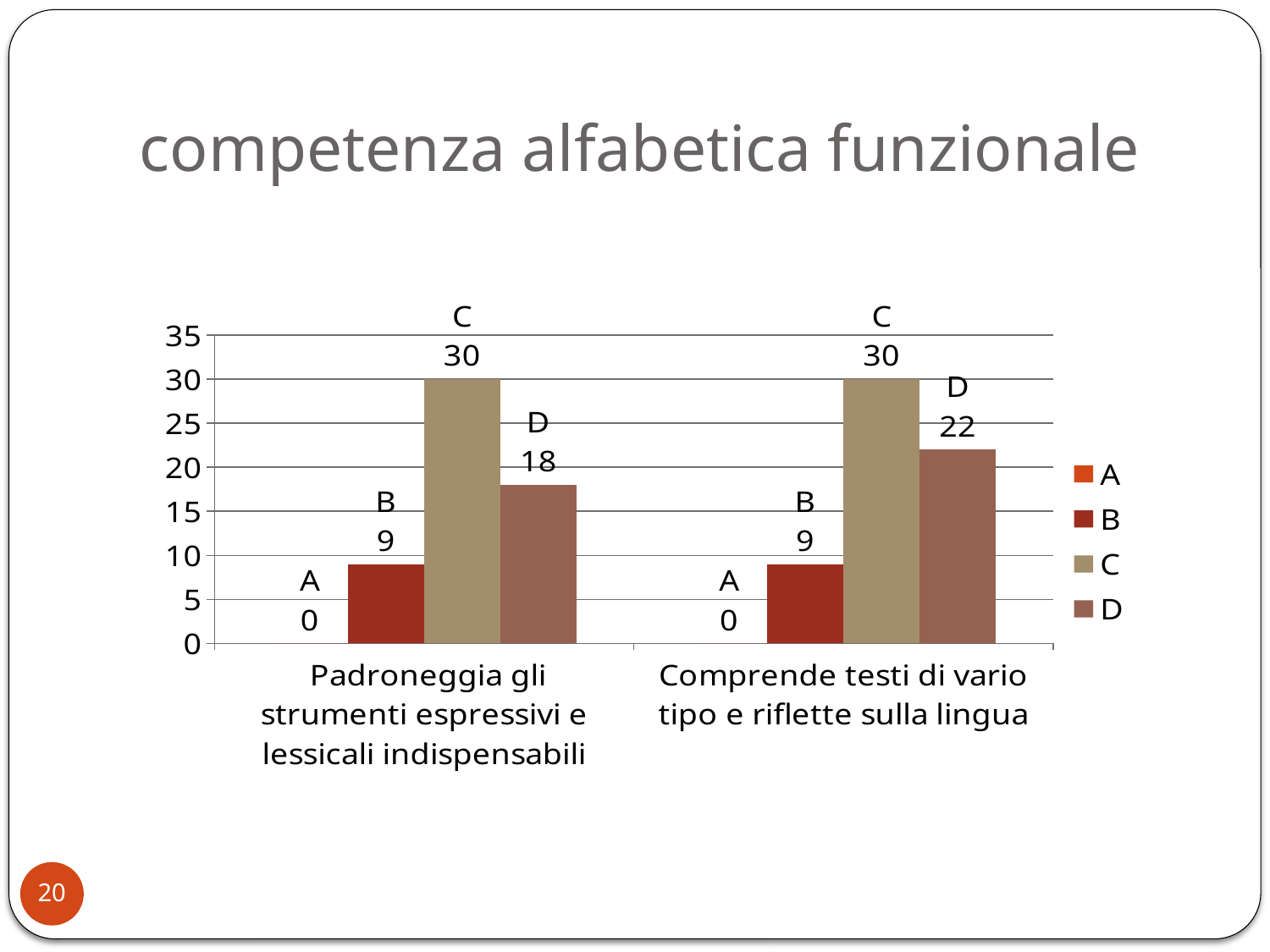
What is the value for series A in the category "Comprende testi di vario tipo e riflette sulla lingua"? 0 What is the difference between the values of series C and series D in the category "Comprende testi di vario tipo e riflette sulla lingua"? 8 What kind of chart is shown on the slide? bar chart How many categories are shown on the x axis? 2 What is the value for series D in the category "Comprende testi di vario tipo e riflette sulla lingua"? 22 What is the value for series B in the category "Padroneggia gli strumenti espressivi e lessicali indispensabili"? 9 Which series has the lowest value in the category "Comprende testi di vario tipo e riflette sulla lingua"? A Which is larger: series D in "Padroneggia gli strumenti espressivi e lessicali indispensabili" or series D in "Comprende testi di vario tipo e riflette sulla lingua"? Comprende testi di vario tipo e riflette sulla lingua What is the difference between the values of series D in the two categories? 4 How many series does the legend list? 4 Which series has the highest value in the category "Padroneggia gli strumenti espressivi e lessicali indispensabili"? C What is the value for series D in the category "Padroneggia gli strumenti espressivi e lessicali indispensabili"? 18